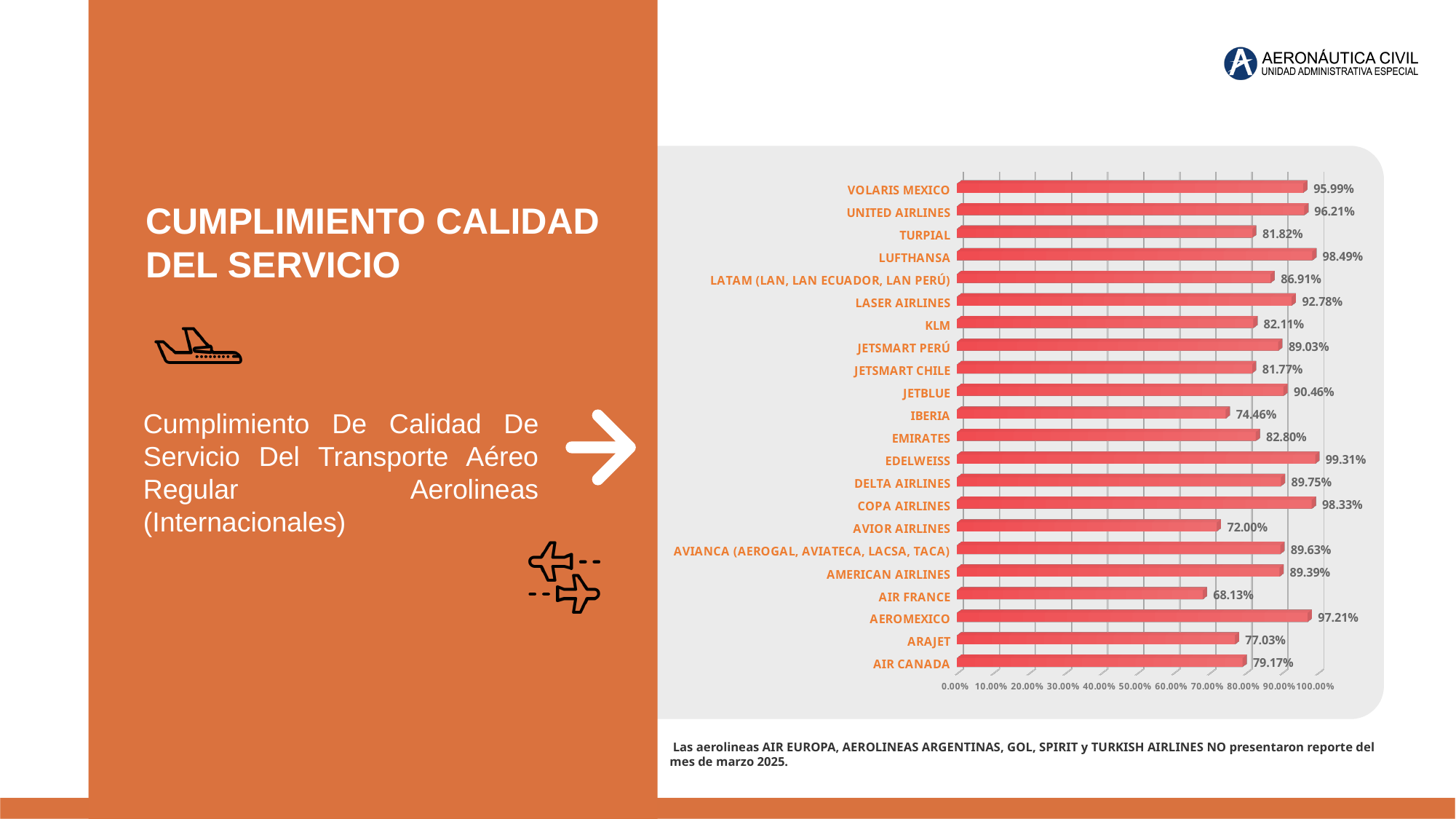
Which airline has the highest value in the chart? EDELWEISS What is the value shown for AIR FRANCE? 68.13% Which has a larger value, KLM or IBERIA? KLM What is the value shown for JETBLUE? 90.46% Which airline has the lowest value in the chart? AIR FRANCE What is the value shown for AVIOR AIRLINES? 72.00% What is the highest tick label on the horizontal axis of the chart? 100.00% What is the value shown for LUFTHANSA? 98.49% How many airlines are shown in the chart? 22 What kind of chart is shown on the slide? Bar chart What is the difference between the values for LUFTHANSA and TURPIAL? 16.67% What is the difference between the values for AEROMEXICO and AIR CANADA? 18.04%